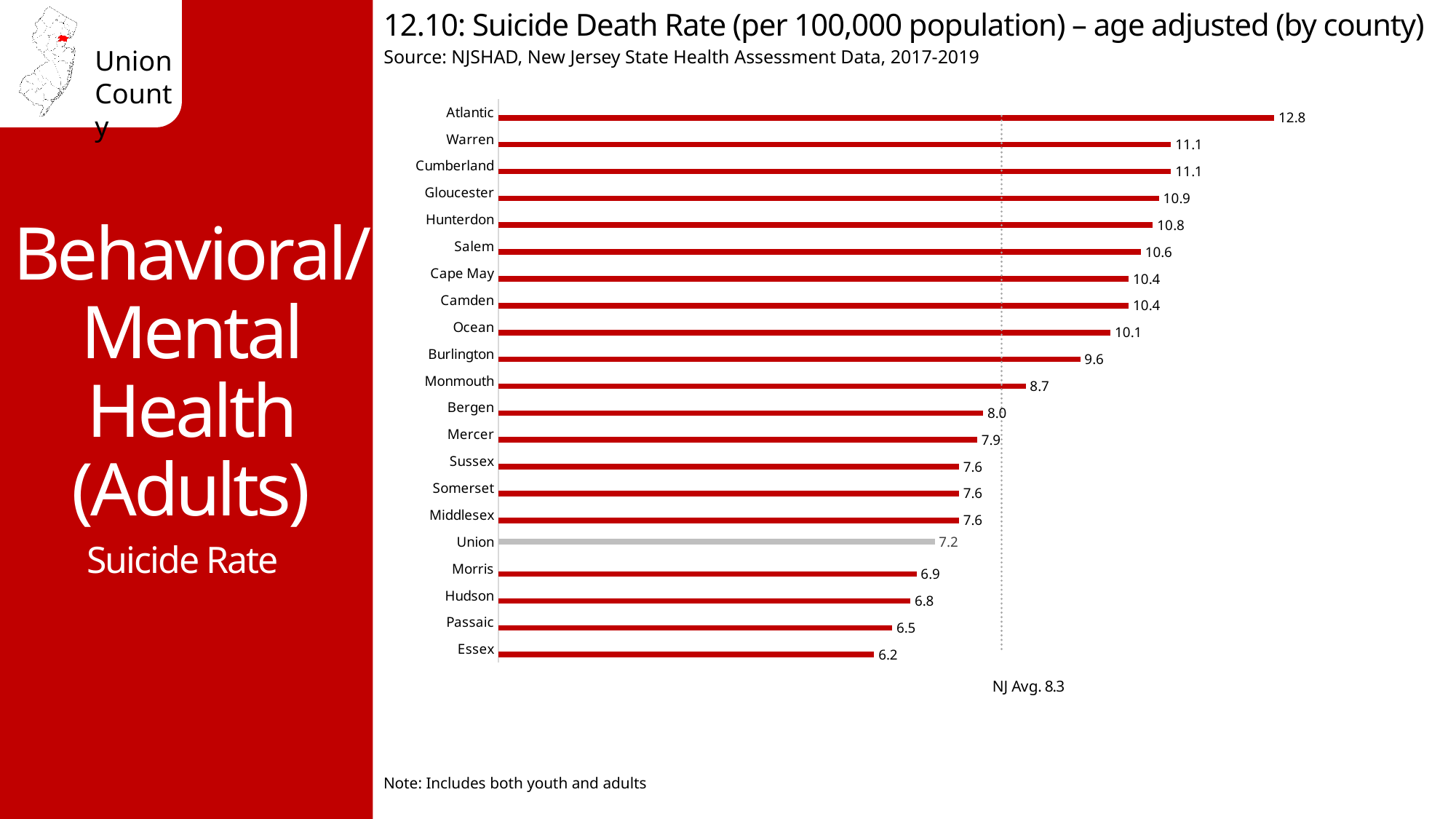
Which county has the highest suicide death rate? Atlantic What type of chart is shown on the slide? Bar chart Which has a higher suicide death rate, Bergen or Morris? Bergen How many counties are shown in the chart? 21 What is the difference between the suicide death rates of Atlantic and Essex counties? 6.6 Which county has the lowest suicide death rate? Essex What is the difference between the suicide death rate of Union County and the NJ average? 1.1 What is the suicide death rate for Monmouth County? 8.7 What is the suicide death rate for Atlantic County? 12.8 What is the suicide death rate for Union County? 7.2 What is the NJ average suicide death rate shown by the dotted line? 8.3 Which county's bar is coloured grey instead of red? Union